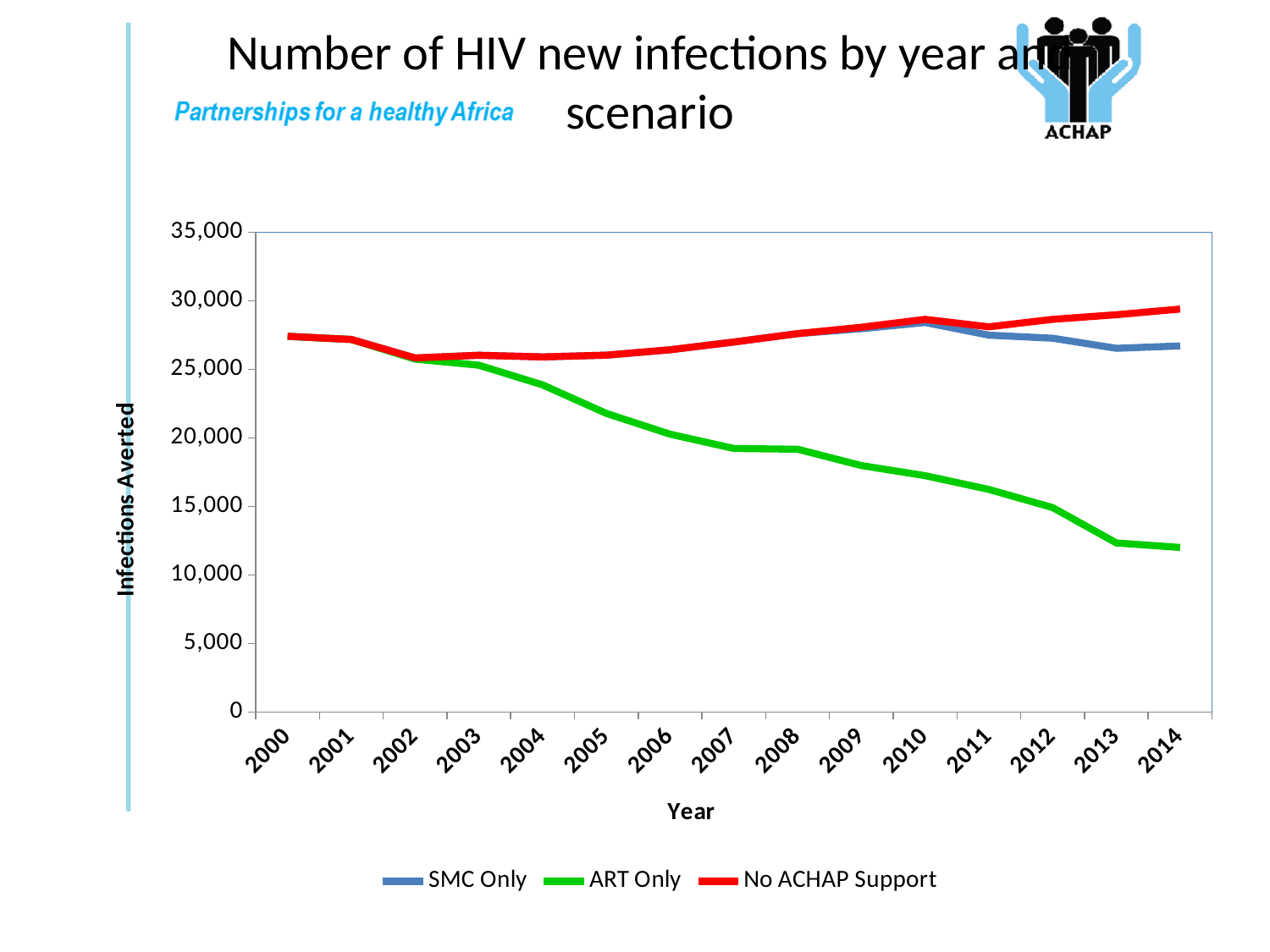
How many years are plotted along the x axis? 15 Is the value for ART Only in 2014 greater or less than 15,000? less Does the No ACHAP Support line rise or fall from 2005 to 2010? rise What kind of chart is shown on the slide? line chart Which series has the lowest value in 2014? ART Only Does the ART Only line rise or fall from 2000 to 2014? fall How many series does the legend list? 3 What is the label on the y axis? Infections Averted In 2012, which is larger: SMC Only or ART Only? SMC Only Is the value for No ACHAP Support in 2014 greater or less than 25,000? greater Is the value for ART Only in 2010 greater or less than 15,000? greater Which series has the highest value in 2014? No ACHAP Support